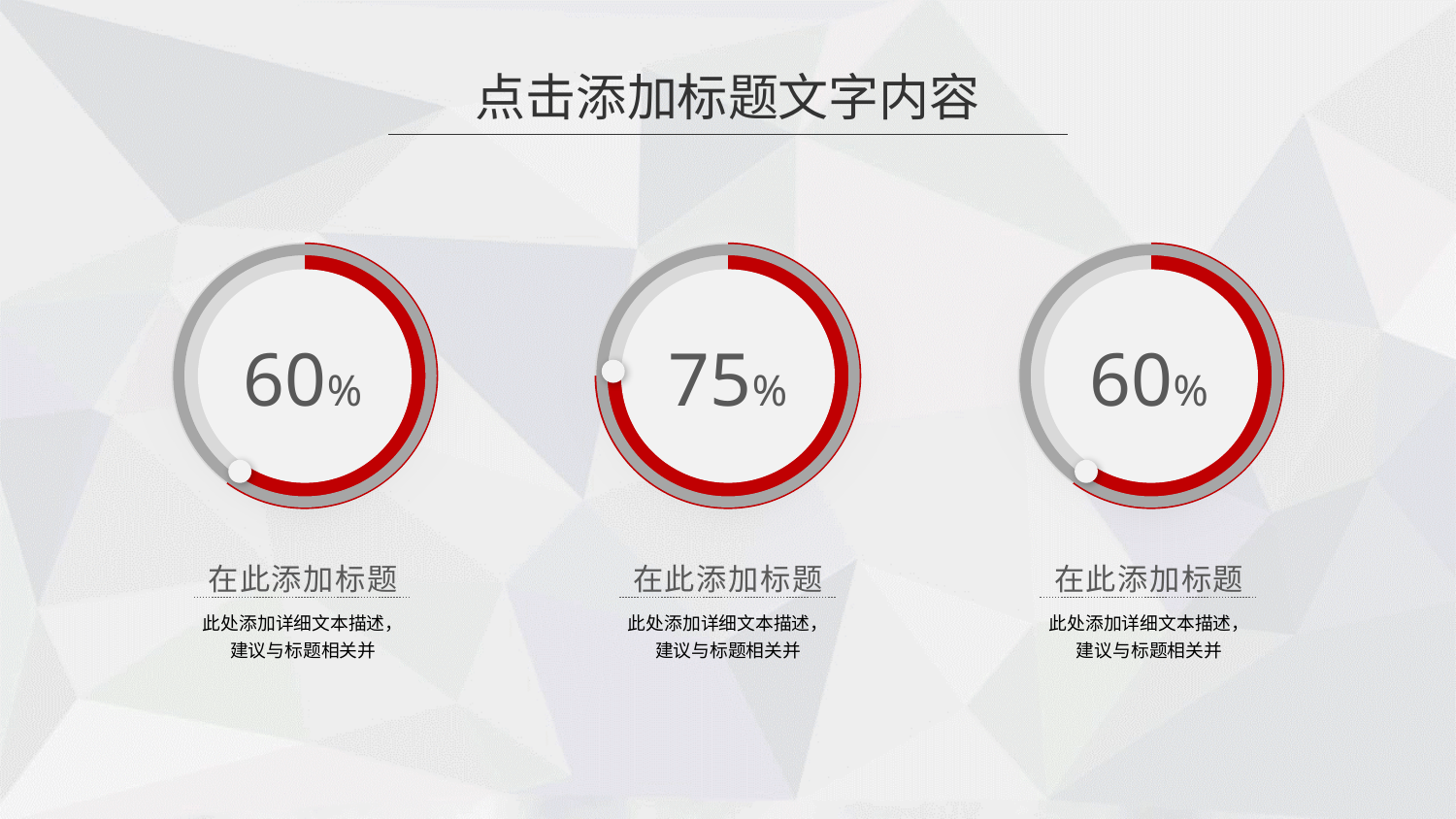
Do the left and right ring charts show the same value? Yes, both show 60% What percentage is shown in the left ring chart? 60% Is the value in the middle ring chart larger or smaller than the value in the left ring chart? Larger Which of the three ring charts shows the highest percentage? The middle one (75%) What is the difference between the middle ring chart's value and the right ring chart's value? 15% What percentage is shown in the right ring chart? 60% How many ring charts are shown on the slide? 3 What colour is the filled portion of each ring chart? Red What percentage is shown in the middle ring chart? 75% What is the title text above the three ring charts? 点击添加标题文字内容 What kind of chart is used to display the percentages on this slide? Ring (donut) progress charts